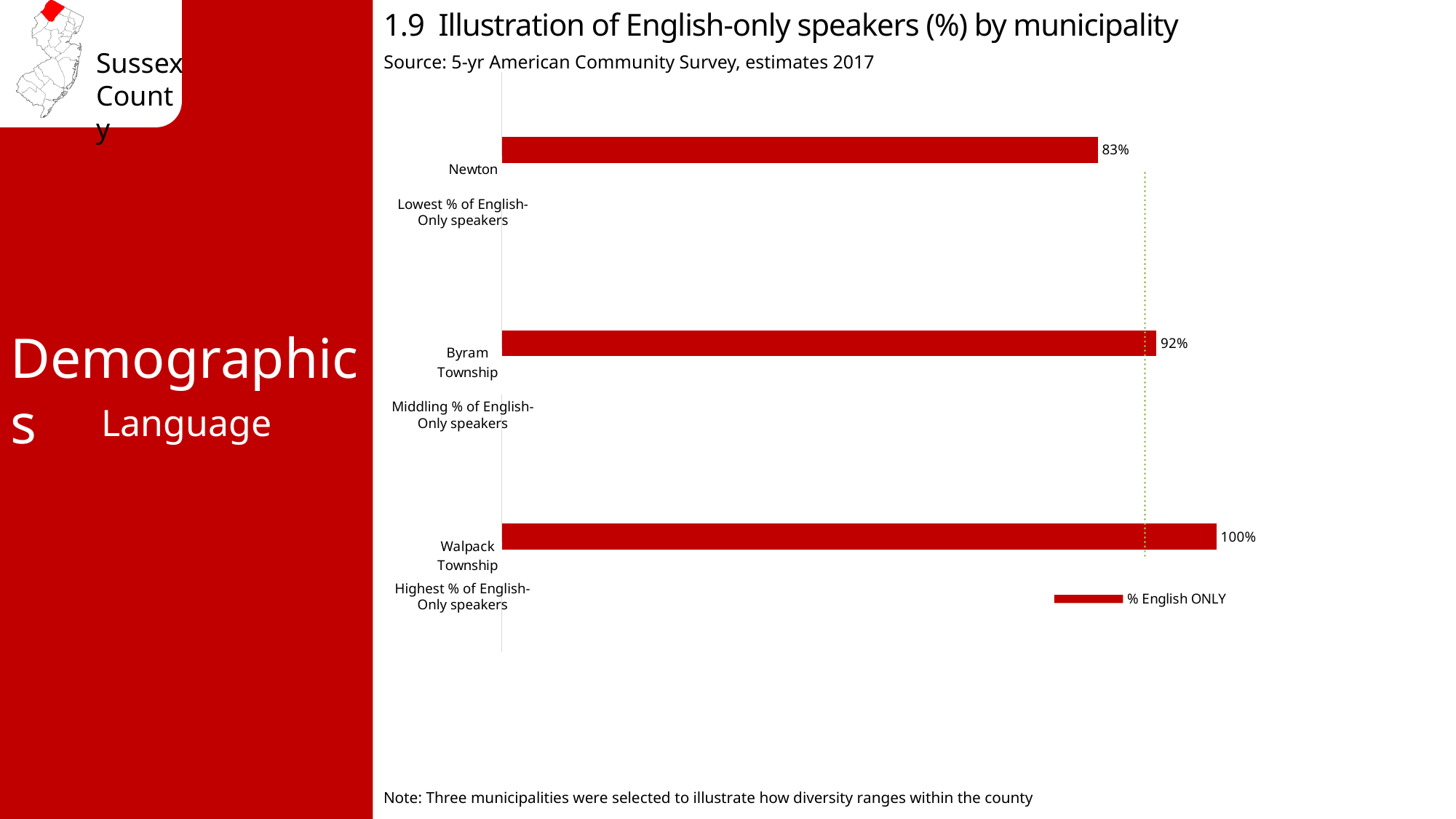
Which has a larger value, Byram Township or Newton? Byram Township What is the value for Walpack Township? 100% What is the value for Byram Township? 92% Which municipality has the lowest percentage of English-only speakers? Newton What kind of chart is shown on the slide? Bar chart What is the difference between the values for Walpack Township and Newton? 17% What is the value for Newton? 83% How many municipalities are shown in the chart? 3 What is the legend entry for the series shown in the chart? % English ONLY What is the difference between the values for Byram Township and Newton? 9% How many series does the legend list? 1 Which municipality has the highest percentage of English-only speakers? Walpack Township